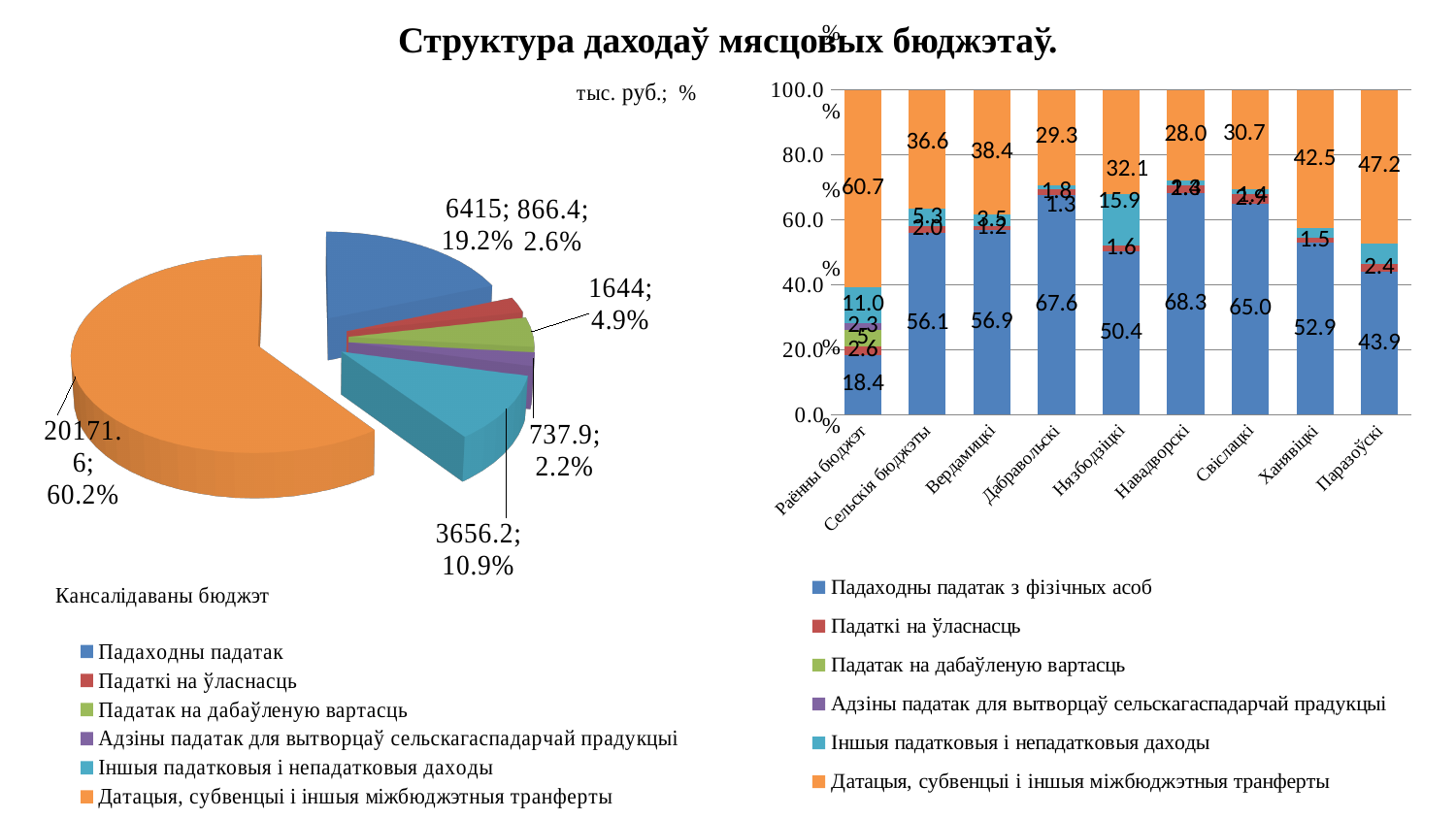
On the stacked bar chart on the right, how many categories are shown on the x axis? 9 On the pie chart (Кансалідаваны бюджэт), which category has the smallest slice? Адзіны падатак для вытворцаў сельскагаспадарчай прадукцыі On the pie chart (Кансалідаваны бюджэт), what value is shown for Іншыя падатковыя і непадатковыя даходы? 3656.2; 10.9% On the pie chart (Кансалідаваны бюджэт), what value is shown for Падаходны падатак? 6415; 19.2% On the stacked bar chart on the right, what is the difference between the Падаходны падатак з фізічных асоб values for Ханявіцкі and Паразоўскі? 9.0 On the pie chart (Кансалідаваны бюджэт), how many series does the legend list? 6 On the pie chart (Кансалідаваны бюджэт), what share does the slice for Датацыя, субвенцыі і іншыя міжбюджэтныя трансферты have? 60.2% What kind of chart is shown on the right side of the slide? Stacked bar chart On the stacked bar chart on the right, which category has the highest value for Датацыя, субвенцыі і іншыя міжбюджэтныя трансферты? Раённы бюджэт On the stacked bar chart on the right, what is the value of Датацыя, субвенцыі і іншыя міжбюджэтныя трансферты for Паразоўскі? 47.2 On the stacked bar chart on the right, which category has the lowest value for Падаходны падатак з фізічных асоб? Раённы бюджэт On the stacked bar chart on the right, what is the value of Падаходны падатак з фізічных асоб for Навадворскі? 68.3